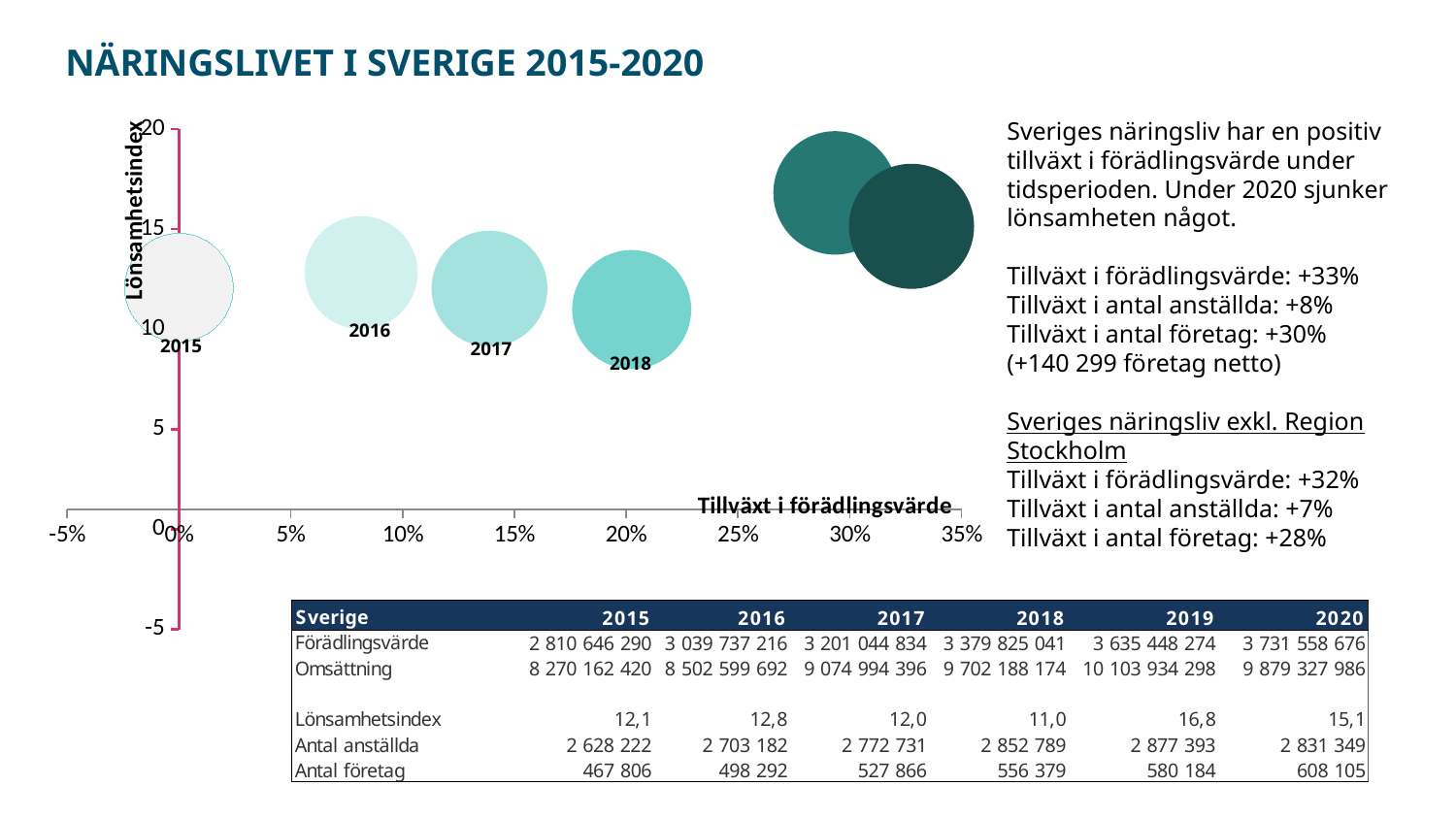
According to the table, what is the difference in Lönsamhetsindex between 2019 and 2020? 1,7 Is the Tillväxt i förädlingsvärde value for the 2018 bubble greater or less than 15%? greater Among the labeled bubbles (2015-2018), which year has the lowest Lönsamhetsindex? 2018 How many bubbles are plotted on the chart? 6 Is the Tillväxt i förädlingsvärde value for the 2015 bubble greater or less than 5%? less What is the title of the slide's chart area? NÄRINGSLIVET I SVERIGE 2015-2020 Which of the labeled bubbles, 2016 or 2018, has the higher Lönsamhetsindex? 2016 Is the Lönsamhetsindex value for the 2018 bubble greater or less than 15? less What is the label of the vertical axis of the chart? Lönsamhetsindex How many bubbles on the chart carry a year label? 4 According to the table, what is the Lönsamhetsindex for 2019? 16,8 What kind of chart is shown on the slide? bubble chart